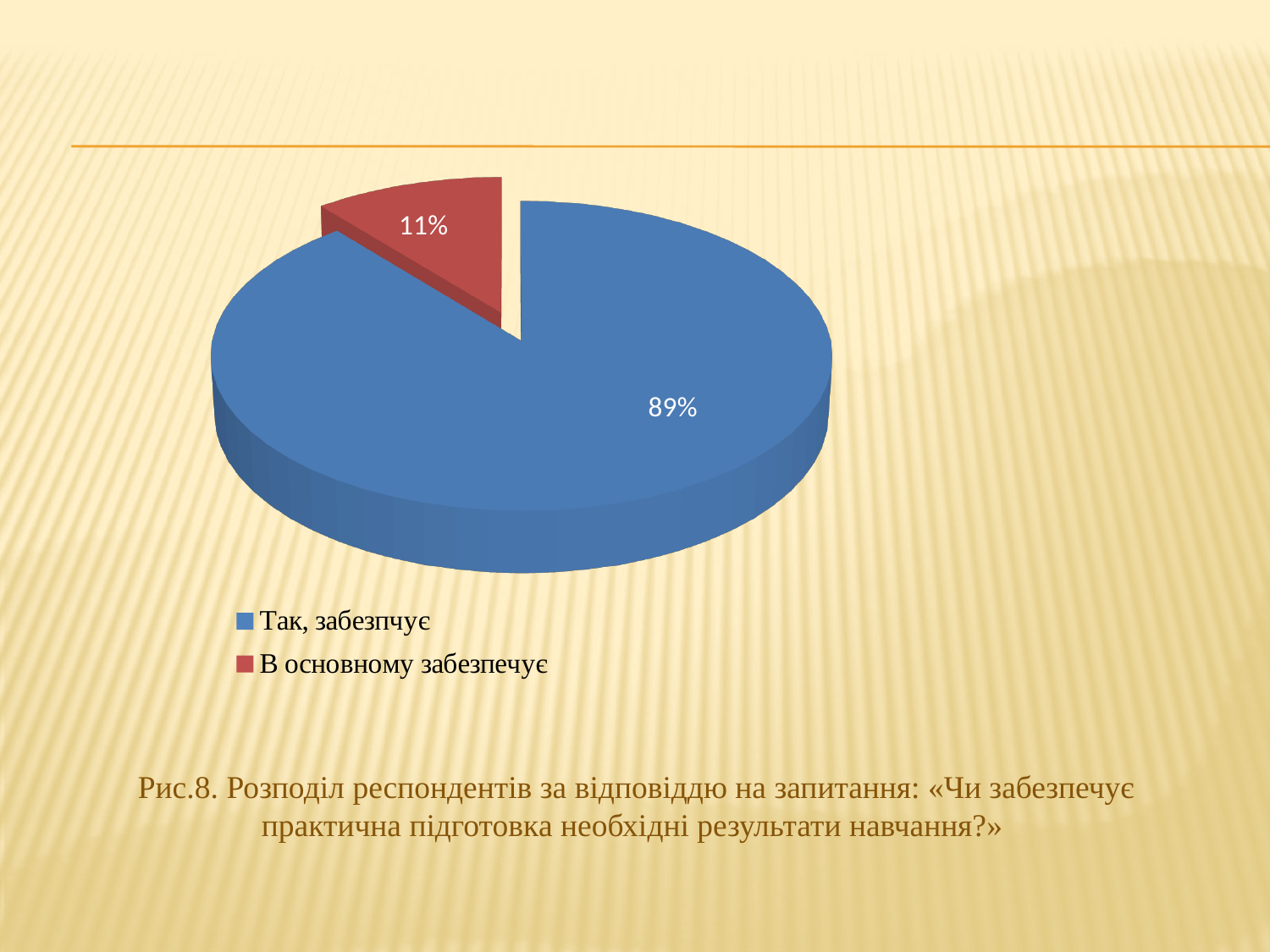
How many slices does the pie chart have? 2 What colour is the slice for "В основному забезпечує"? Red How many entries does the legend list? 2 What colour is the slice for "Так, забезпчує"? Blue Which category has the largest slice of the pie? Так, забезпчує What is the difference in percentage points between the "Так, забезпчує" slice and the "В основному забезпечує" slice? 78 Which slice is larger: "Так, забезпчує" or "В основному забезпечує"? Так, забезпчує What share of the pie does "Так, забезпчує" represent? 89% What kind of chart is shown on the slide? Pie chart What share of the pie does "В основному забезпечує" represent? 11% Which category has the smallest slice of the pie? В основному забезпечує